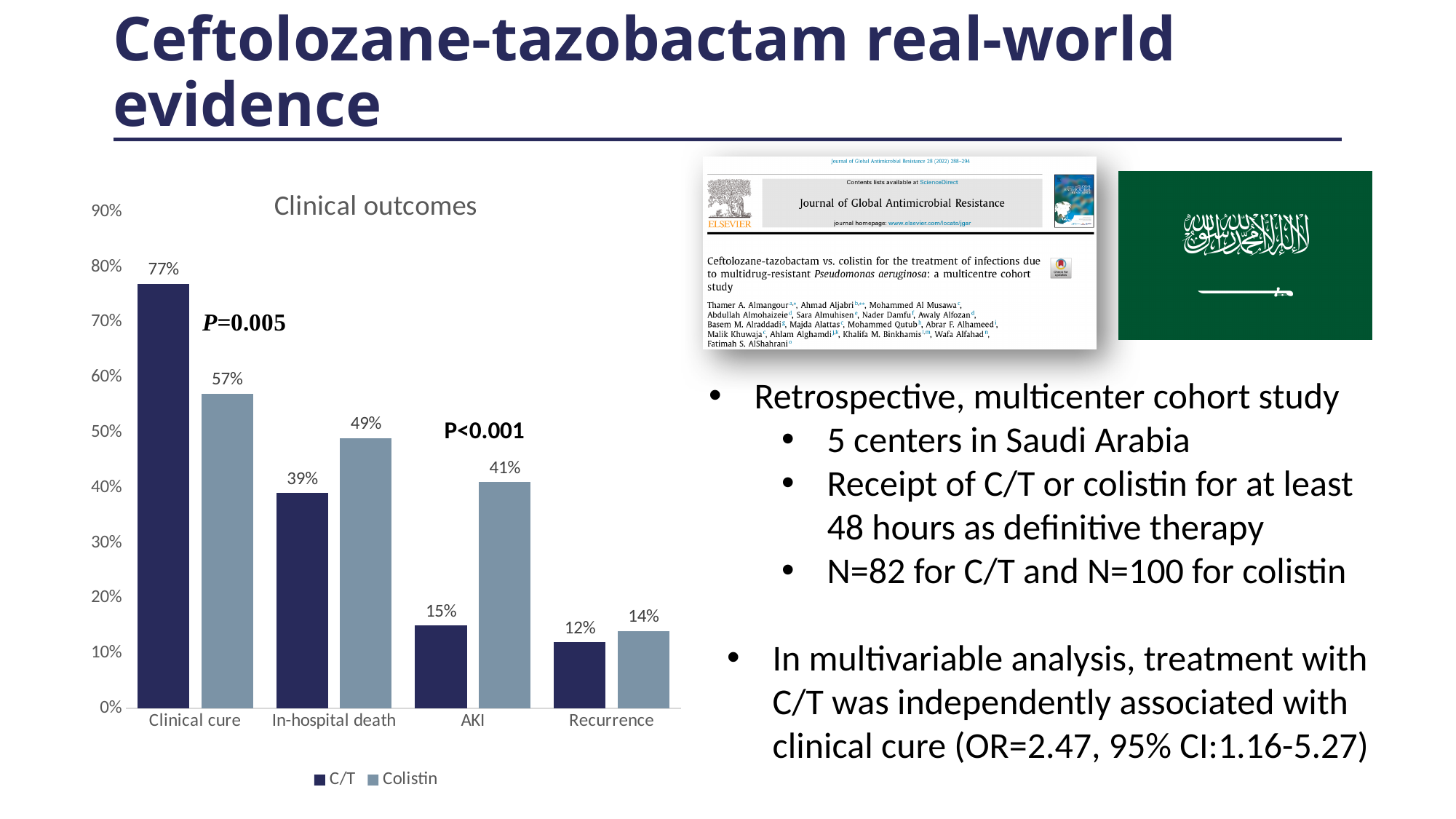
What is the AKI rate for Colistin? 41% Which group has the higher in-hospital death rate, C/T or Colistin? Colistin What is the clinical cure rate for C/T? 77% What is the difference between the C/T and Colistin clinical cure rates? 20% What is the in-hospital death rate for C/T? 39% How many series does the legend list? 2 What type of chart is shown on the slide? Bar chart Which outcome category has the lowest value for Colistin? Recurrence How many outcome categories are shown on the x axis? 4 What is the difference between the Colistin and C/T AKI rates? 26% What is the recurrence rate for Colistin? 14% Which outcome category has the highest value for C/T? Clinical cure